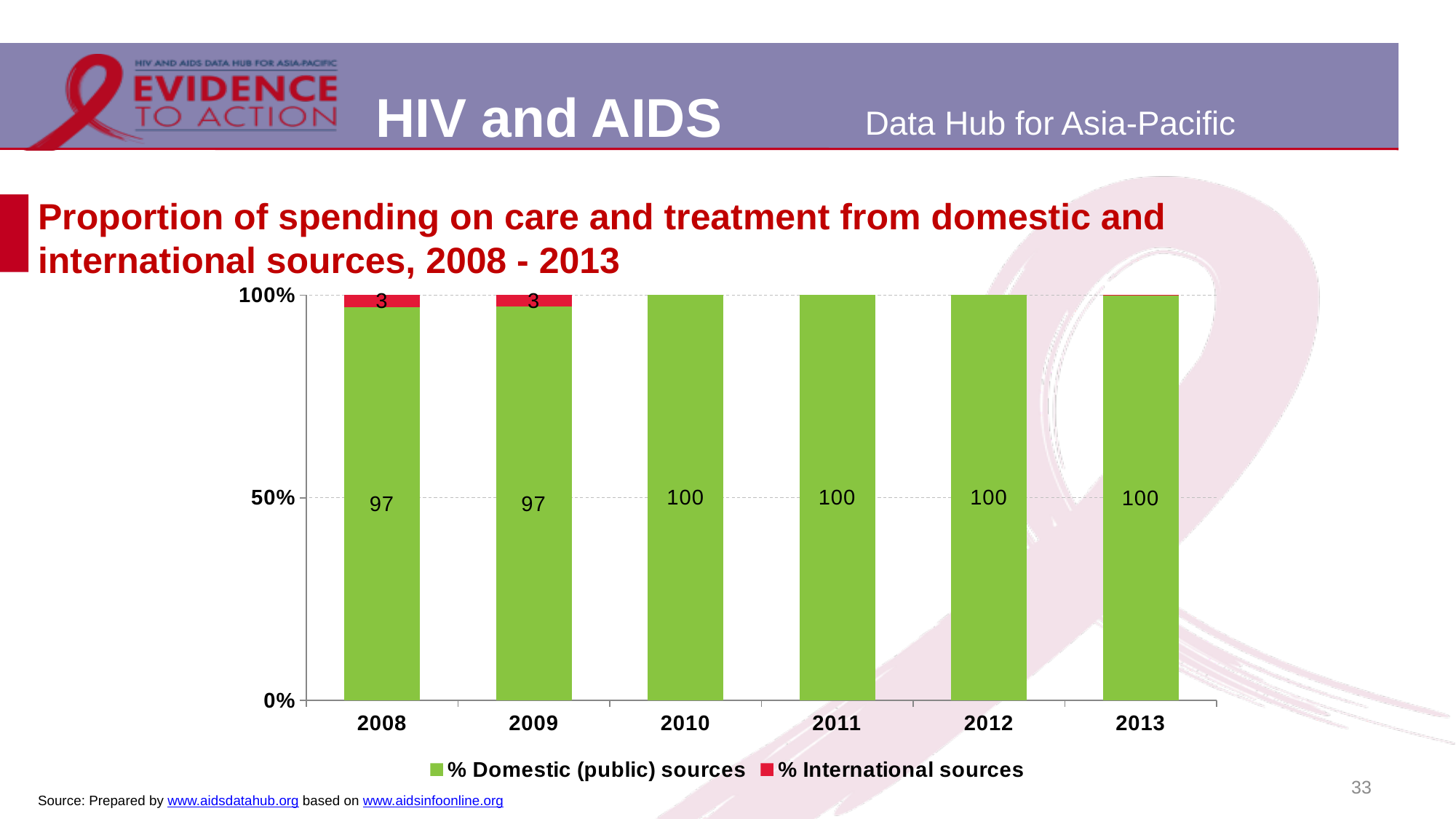
What is the difference between the % Domestic (public) sources value in 2010 and in 2008? 3 What is the value for % Domestic (public) sources in 2008? 97 What is the value for % International sources in 2009? 3 Which year has the lowest value for % Domestic (public) sources? 2008 and 2009 What is the value for % Domestic (public) sources in 2012? 100 What kind of chart is shown on the slide? Stacked bar chart Is the % Domestic (public) sources value larger in 2009 or in 2011? 2011 Does the % Domestic (public) sources value rise or fall from 2008 to 2013? Rise How many years are shown on the x axis? 6 How many series does the legend list? 2 Which colour represents % International sources in the chart? Red What is the total of the stacked bar for 2008? 100